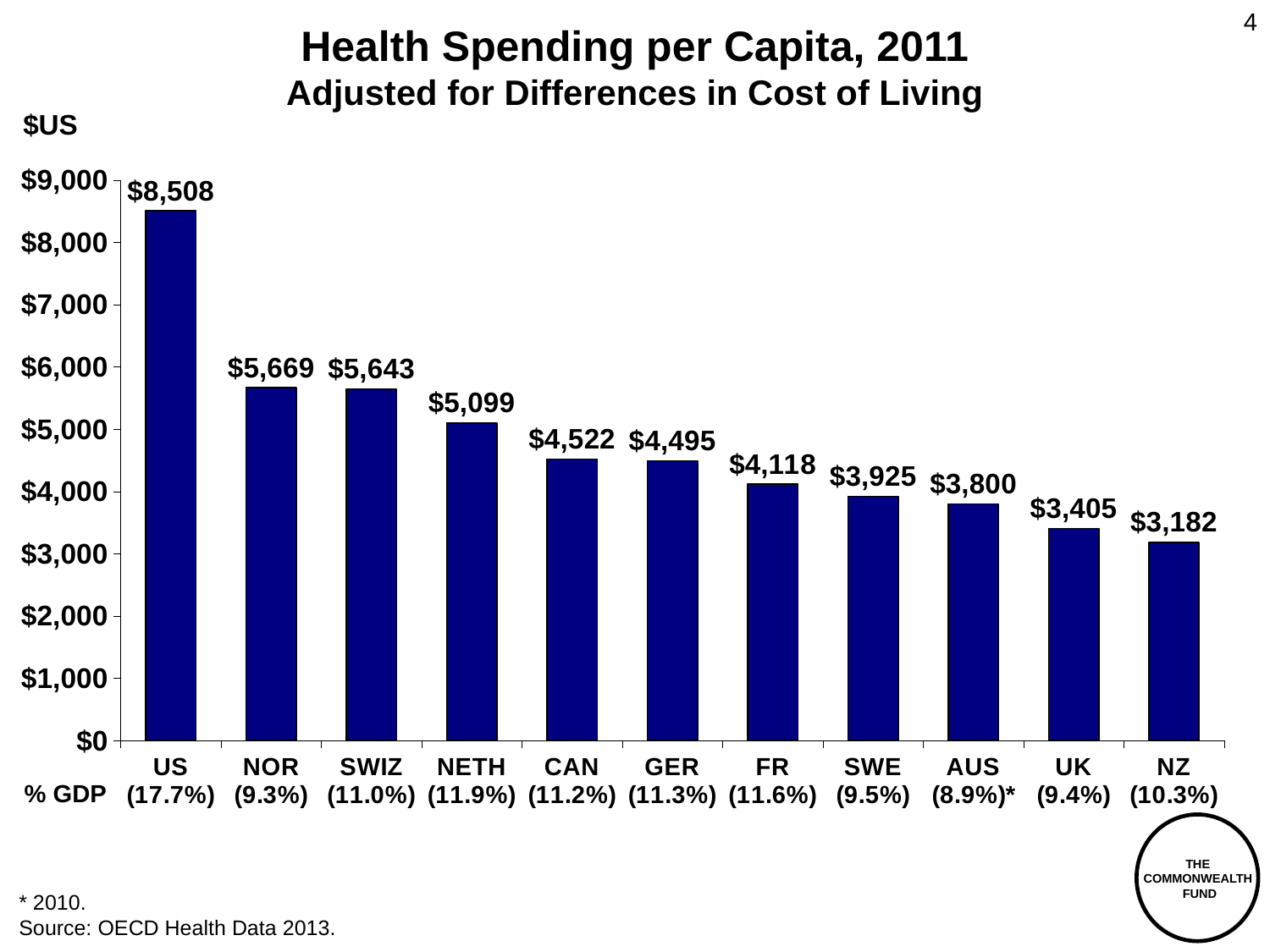
What is the health spending per capita for AUS? $3,800 What is the health spending per capita for NETH? $5,099 Which country has the lowest health spending per capita? NZ Is the value for SWE greater or less than $4,000? less What is the health spending per capita for the US? $8,508 How many countries are shown in the chart? 11 What is the difference in health spending per capita between the UK and NZ? $223 What percentage of GDP is shown for the US below the chart? 17.7% Which country has the highest health spending per capita? US What is the difference in health spending per capita between the US and NOR? $2,839 Which has higher health spending per capita, CAN or FR? CAN What kind of chart is shown on the slide? bar chart